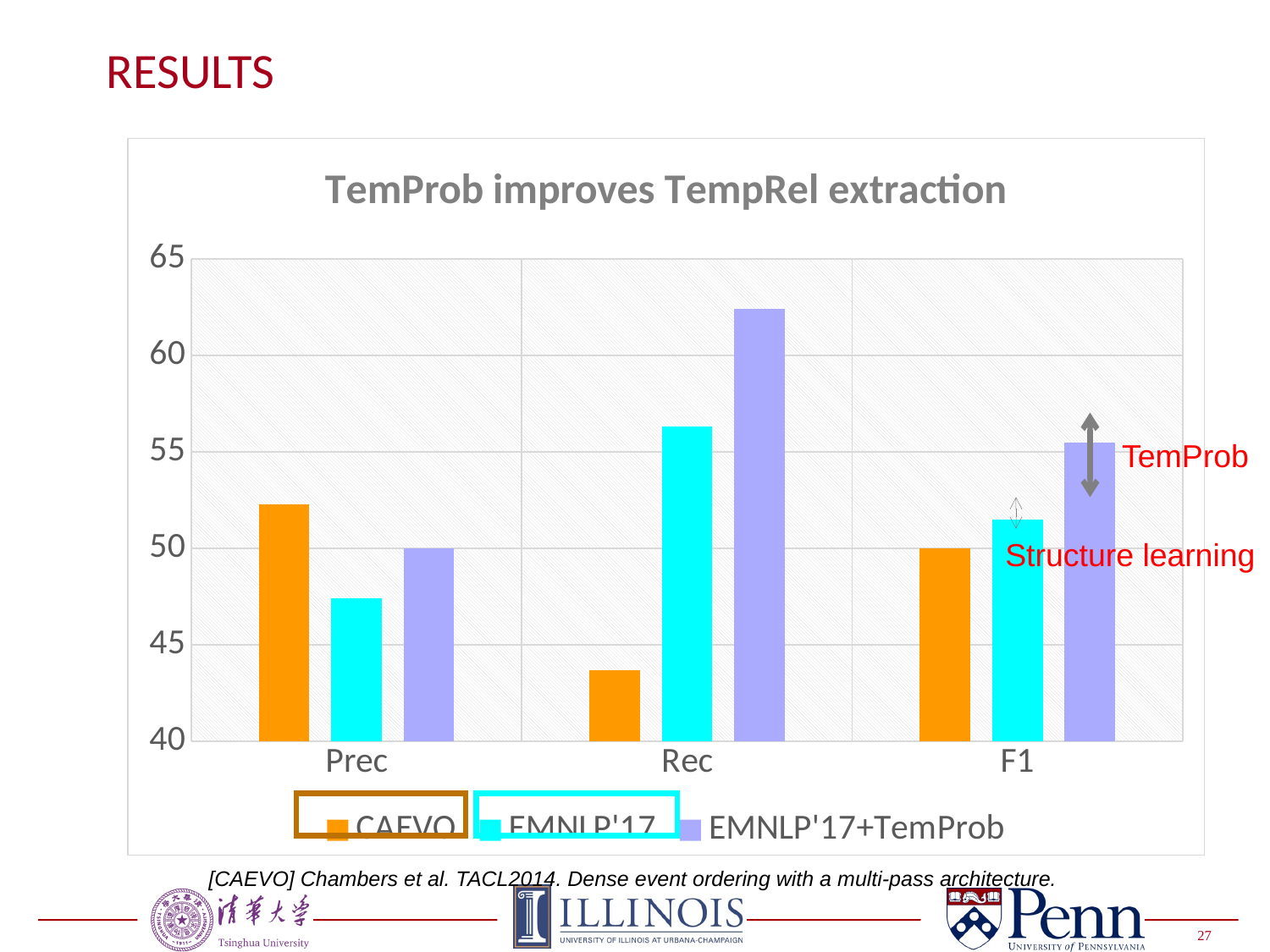
Is the value of EMNLP'17+TemProb for Rec greater or less than 60? greater For F1, which is larger: CAEVO or EMNLP'17+TemProb? EMNLP'17+TemProb Which series has the lowest value for Rec? CAEVO Is the value of CAEVO for Rec greater or less than 45? less How many categories are shown on the x axis? 3 How many series does the legend list? 3 Which series has the highest value for Prec? CAEVO For Prec, which is larger: CAEVO or EMNLP'17? CAEVO What is the title of the chart? TemProb improves TempRel extraction What type of chart is shown on the slide? bar chart Is the value of EMNLP'17 for Prec greater or less than 50? less Which series has the highest value for Rec? EMNLP'17+TemProb